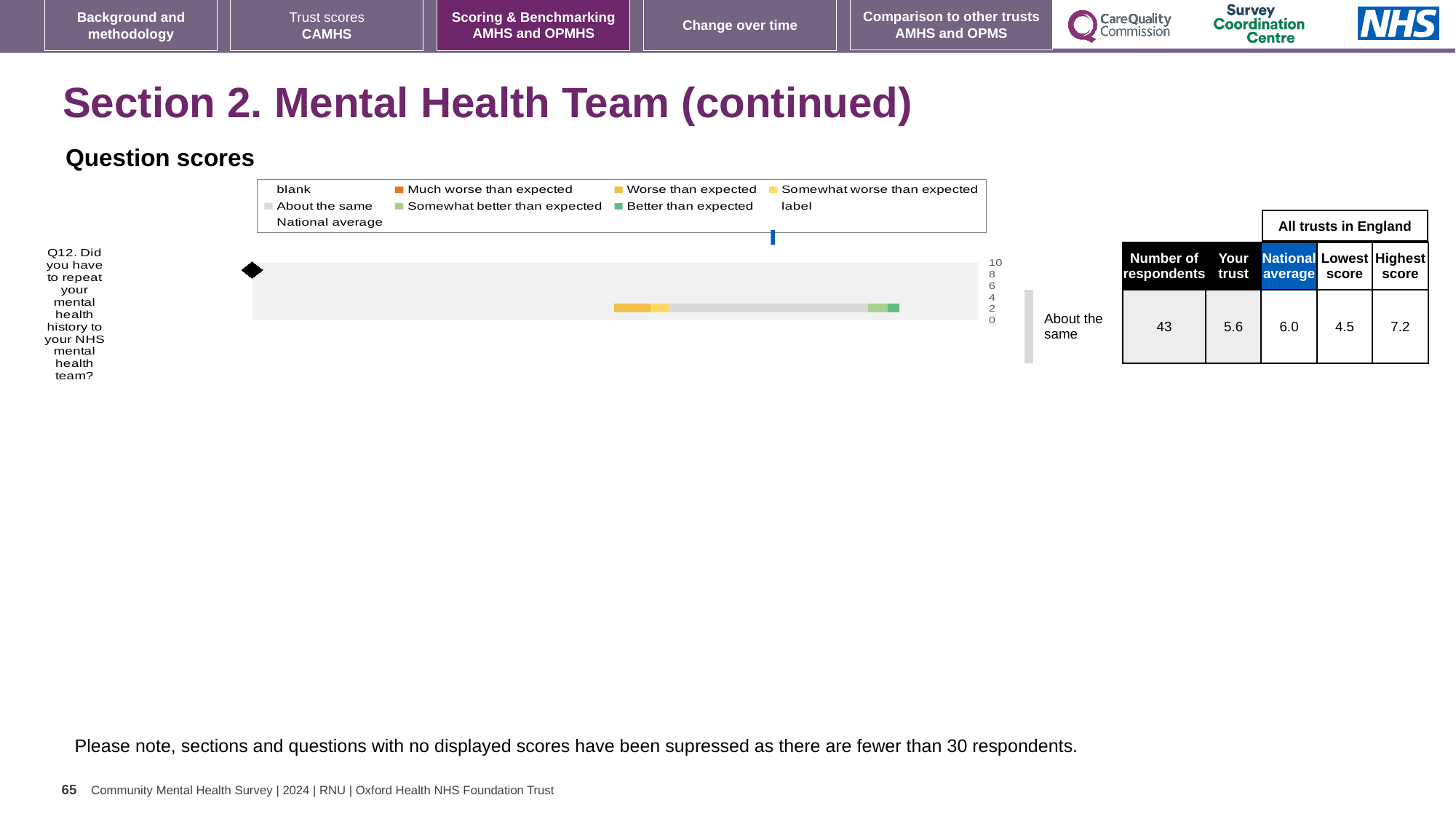
What is the highest score among all trusts in England for Q12? 7.2 For Q12, which is larger: the 'Your trust' score or the national average? National average Is the 'Your trust' score for Q12 greater or less than 6? less What is the lowest score among all trusts in England for Q12? 4.5 What is the difference between the highest score and the lowest score for Q12? 2.7 What colour does the legend use for 'Much worse than expected'? orange What kind of chart is used to show the Q12 question score? bar chart What is the 'Your trust' score for Q12 in the table beside the chart? 5.6 What is the national average score for Q12? 6.0 How many respondents answered Q12? 43 How many questions are plotted in the Question scores chart? 1 What benchmark category label is shown to the right of the Q12 bar? About the same